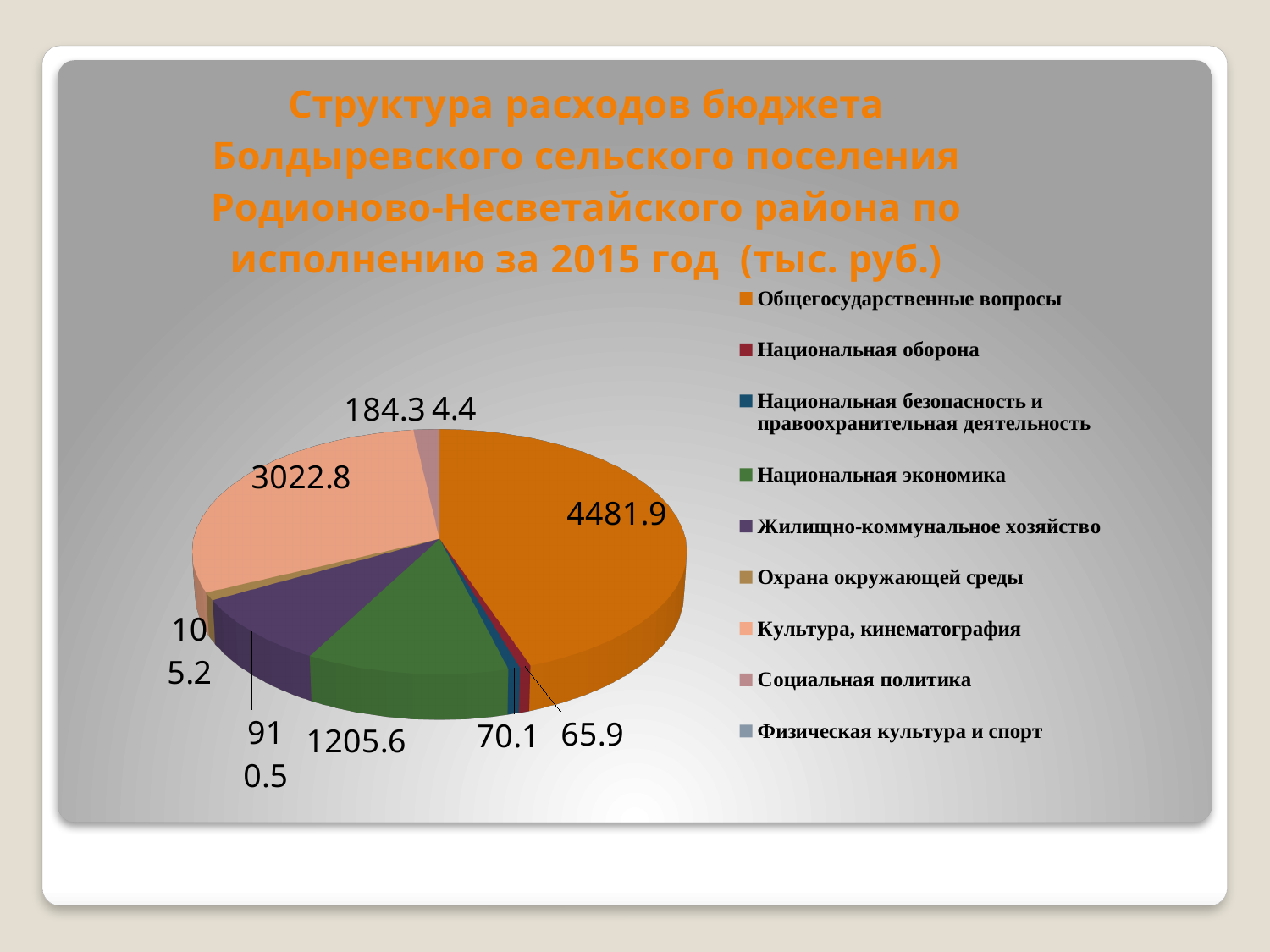
What is the value for Физическая культура и спорт? 4.4 What is the difference between the values for Общегосударственные вопросы and Культура, кинематография? 1459.1 What is the value for Национальная оборона? 65.9 What is the value for Социальная политика? 184.3 What is the value for Культура, кинематография? 3022.8 What is the value for Национальная экономика? 1205.6 Which category has the largest slice of the pie? Общегосударственные вопросы Which category has the smallest value in the pie chart? Физическая культура и спорт What kind of chart is shown on the slide? pie chart Which is larger: the value for Национальная оборона or the value for Национальная безопасность и правоохранительная деятельность? Национальная безопасность и правоохранительная деятельность How many categories does the legend of the pie chart list? 9 What is the value for Общегосударственные вопросы? 4481.9